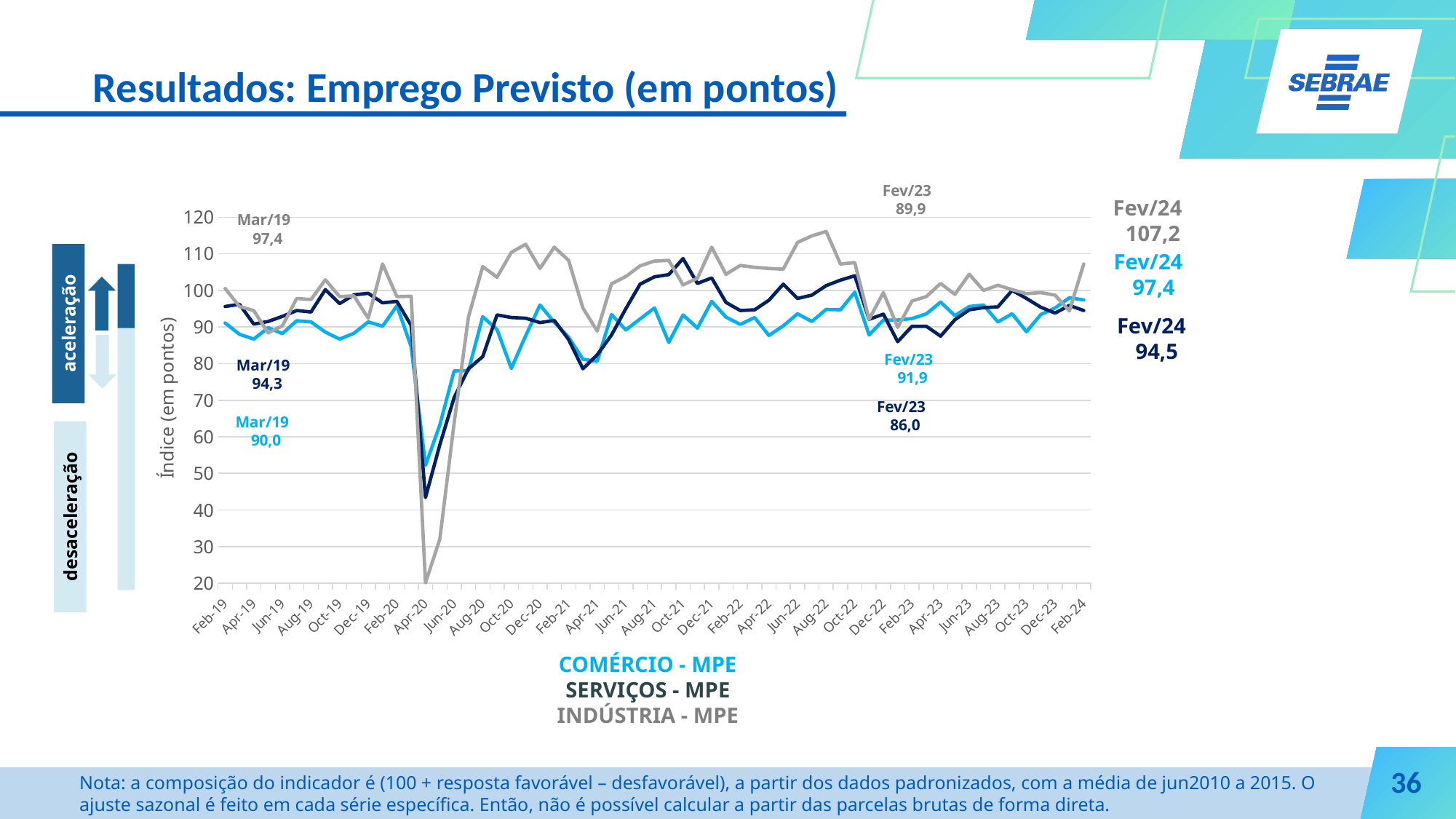
What is the value for COMÉRCIO - MPE in Mar/19? 90,0 What type of chart is shown on the slide? line chart How many series does the legend list? 3 What is the difference between the INDÚSTRIA - MPE value in Fev/24 and its value in Fev/23? 17,3 What is the value for SERVIÇOS - MPE in Fev/23? 86,0 What is the title of the slide's chart section? Resultados: Emprego Previsto (em pontos) Which series has the highest labelled value in Fev/24? INDÚSTRIA - MPE Which series has the lowest labelled value in Fev/23? SERVIÇOS - MPE What is the value for COMÉRCIO - MPE in Fev/24? 97,4 What is the value for INDÚSTRIA - MPE in Fev/24? 107,2 Is the value for INDÚSTRIA - MPE in Apr-20 greater or less than 40? less Which is larger in Mar/19: the SERVIÇOS - MPE value or the COMÉRCIO - MPE value? SERVIÇOS - MPE